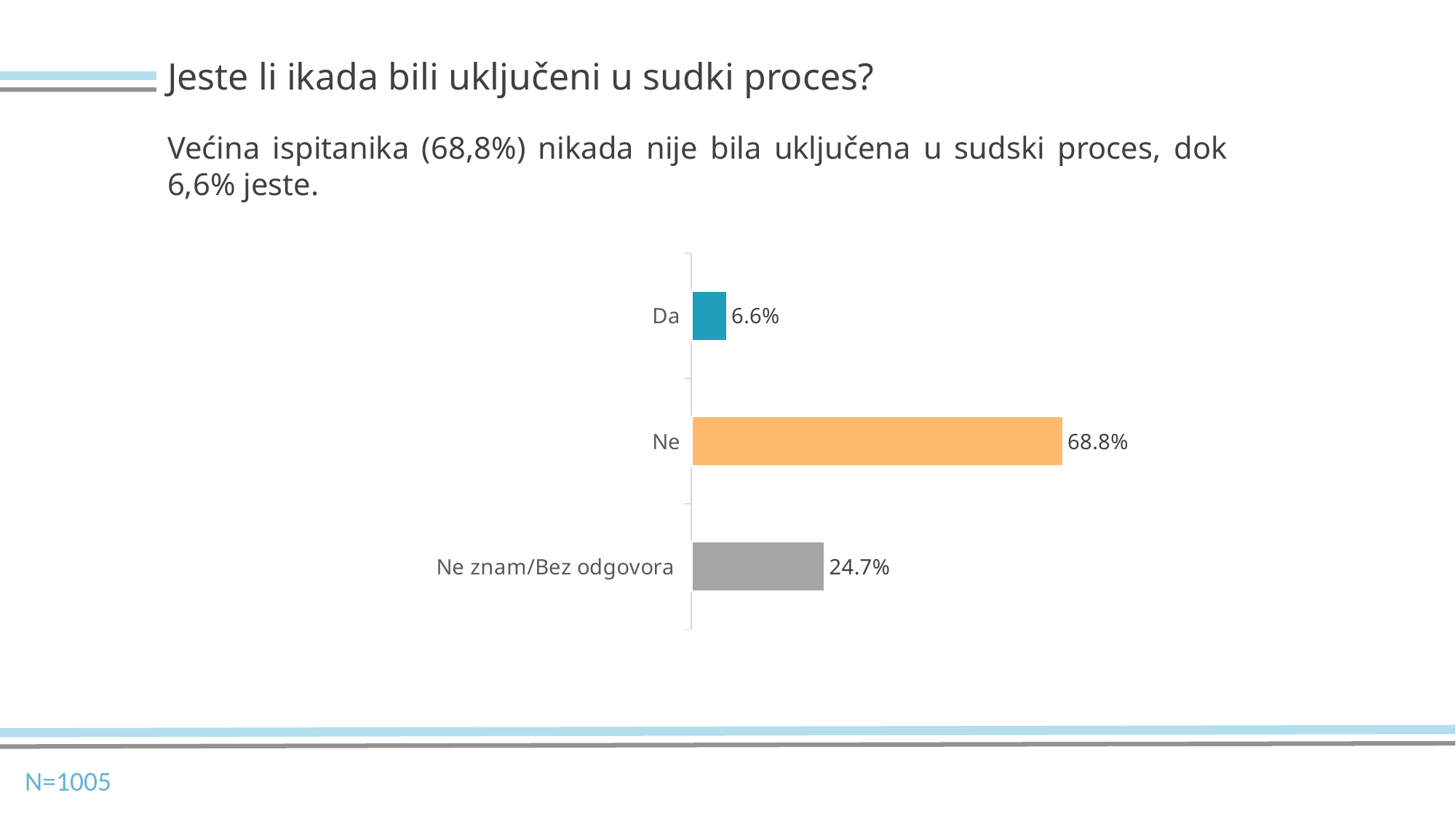
What is the difference between the values for "Ne" and "Ne znam/Bez odgovora"? 44.1% What sample size (N) is stated on the slide? N=1005 What is the difference between the values for "Ne" and "Da"? 62.2% Which is larger, the value for "Ne znam/Bez odgovora" or the value for "Da"? Ne znam/Bez odgovora What colour is the bar for "Ne"? Orange Which category has the lowest value? Da How many categories are shown in the chart? 3 What is the value for "Ne"? 68.8% What is the value for "Da"? 6.6% Which category has the highest value? Ne What kind of chart is shown on the slide? Bar chart What is the value for "Ne znam/Bez odgovora"? 24.7%